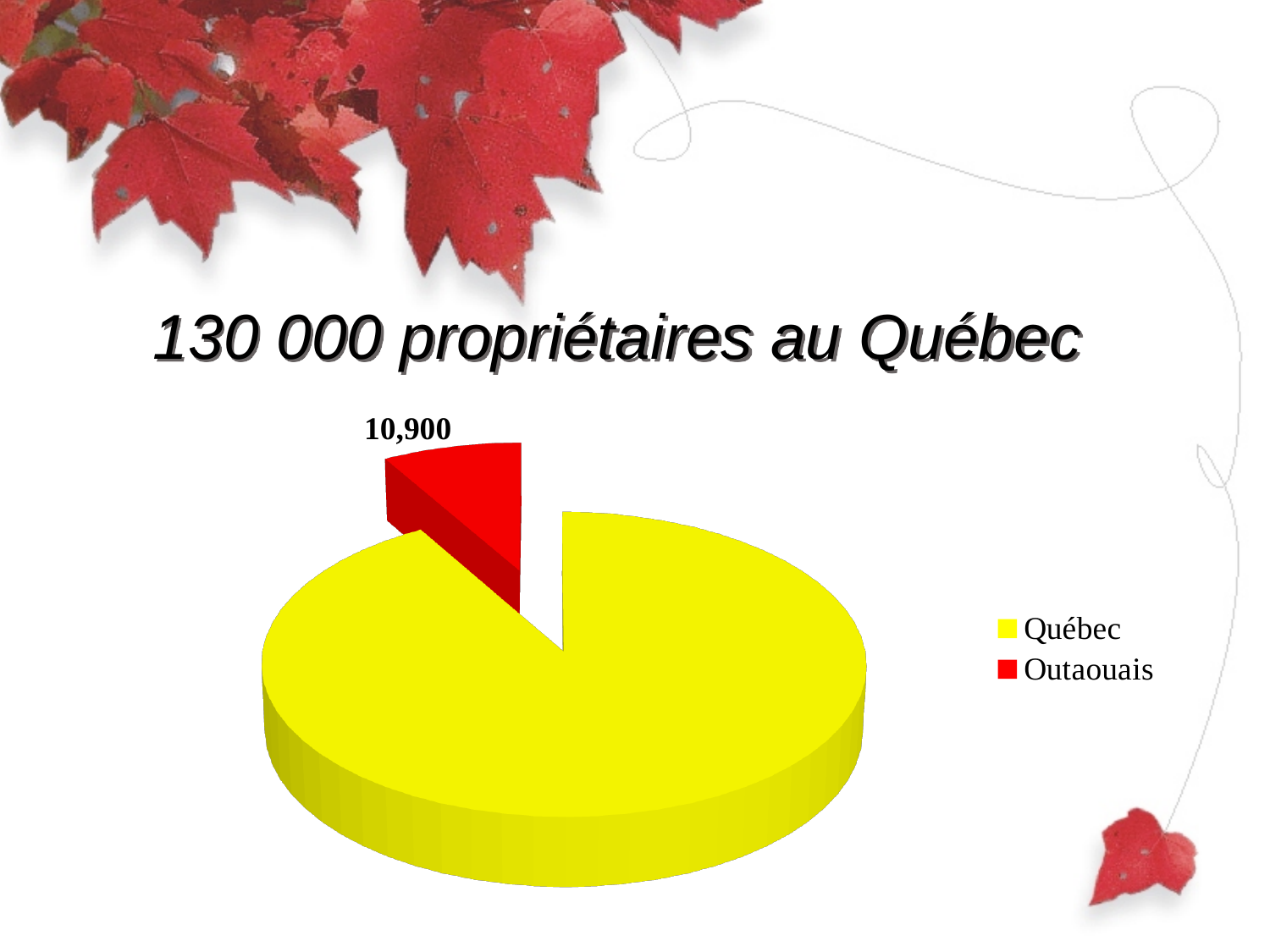
What kind of chart is shown on the slide? Pie chart What is the title text shown above the pie chart? 130 000 propriétaires au Québec Which slice is larger, Québec or Outaouais? Québec Which category has the largest slice in the pie chart? Québec How many entries does the legend of the pie chart list? 2 What colour is the Outaouais slice in the pie chart? Red Which category has the smallest slice in the pie chart? Outaouais How many slices does the pie chart have? 2 What value is shown for the Outaouais slice of the pie chart? 10,900